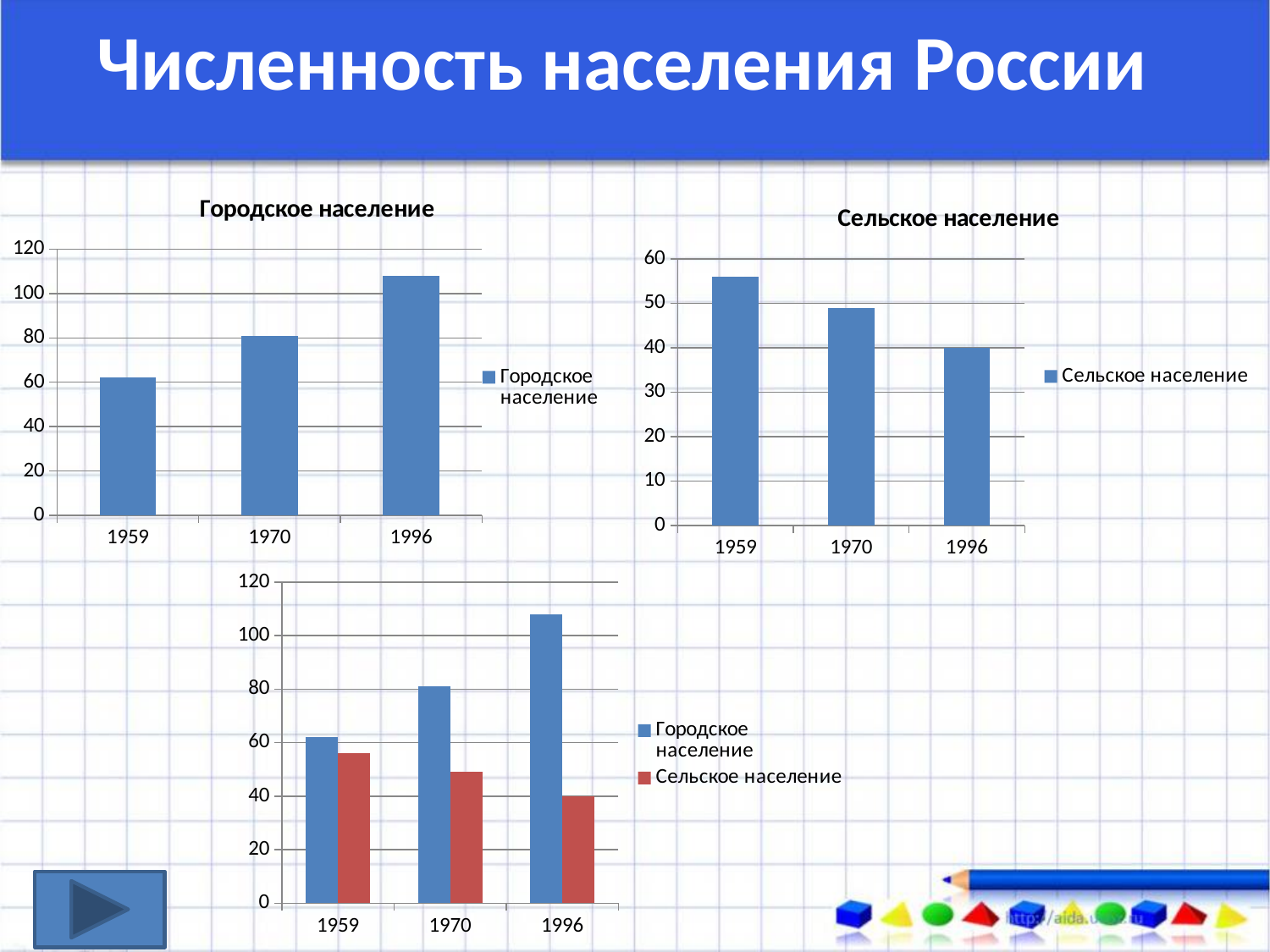
How many years are shown on the x axis of the "Сельское население" chart? 3 In the "Городское население" chart, which year has the lowest value? 1959 In the "Городское население" chart, which year has the highest value? 1996 How many series does the legend of the bottom chart list? 2 In the "Сельское население" chart, do the values rise or fall from 1959 to 1996? fall In the "Городское население" chart, is the value for 1996 greater or less than 100? greater In the "Сельское население" chart, is the value for 1959 greater or less than 50? greater What kind of chart is the "Городское население" chart? bar chart In the bottom chart, what colour are the Сельское население bars? red In the "Городское население" chart, do the values rise or fall from 1959 to 1996? rise In the bottom chart, which is larger for 1970: Городское население or Сельское население? Городское население In the "Сельское население" chart, which year has the highest value? 1959